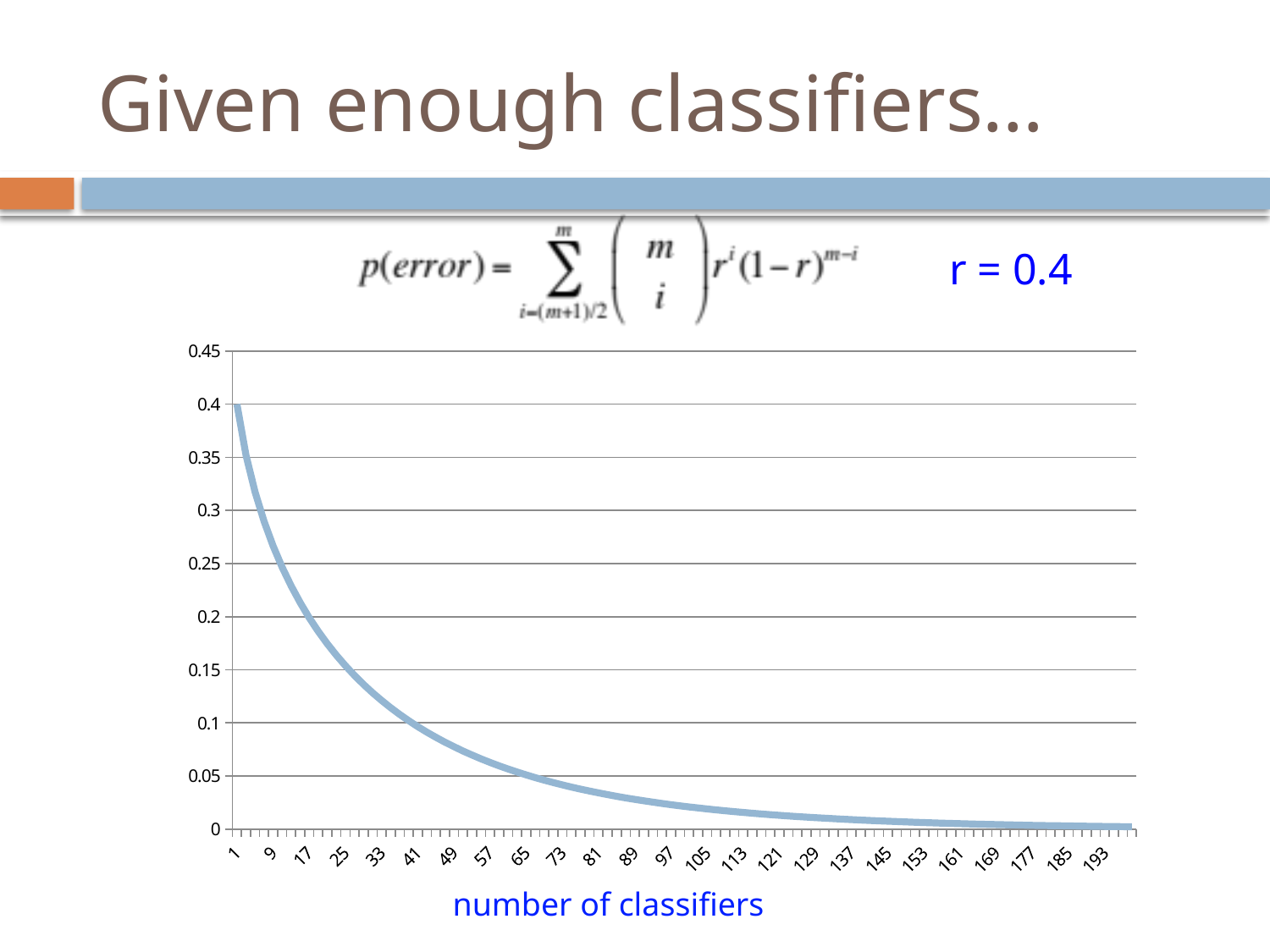
What is the label of the x axis? number of classifiers At which number of classifiers is p(error) highest? 1 Which is larger: p(error) at 9 classifiers or at 57 classifiers? 9 classifiers Is the value of p(error) at 97 classifiers greater or less than 0.05? less Is the value of p(error) at 9 classifiers greater or less than 0.25? greater Is the value of p(error) at 33 classifiers greater or less than 0.2? less At which labelled number of classifiers is p(error) lowest? 193 How many tick labels are shown on the x axis? 25 Does p(error) rise or fall as the number of classifiers increases? fall What kind of chart is shown on the slide? line chart What value of r is stated for the plotted curve? r = 0.4 What is the value of p(error) when the number of classifiers is 1? 0.4